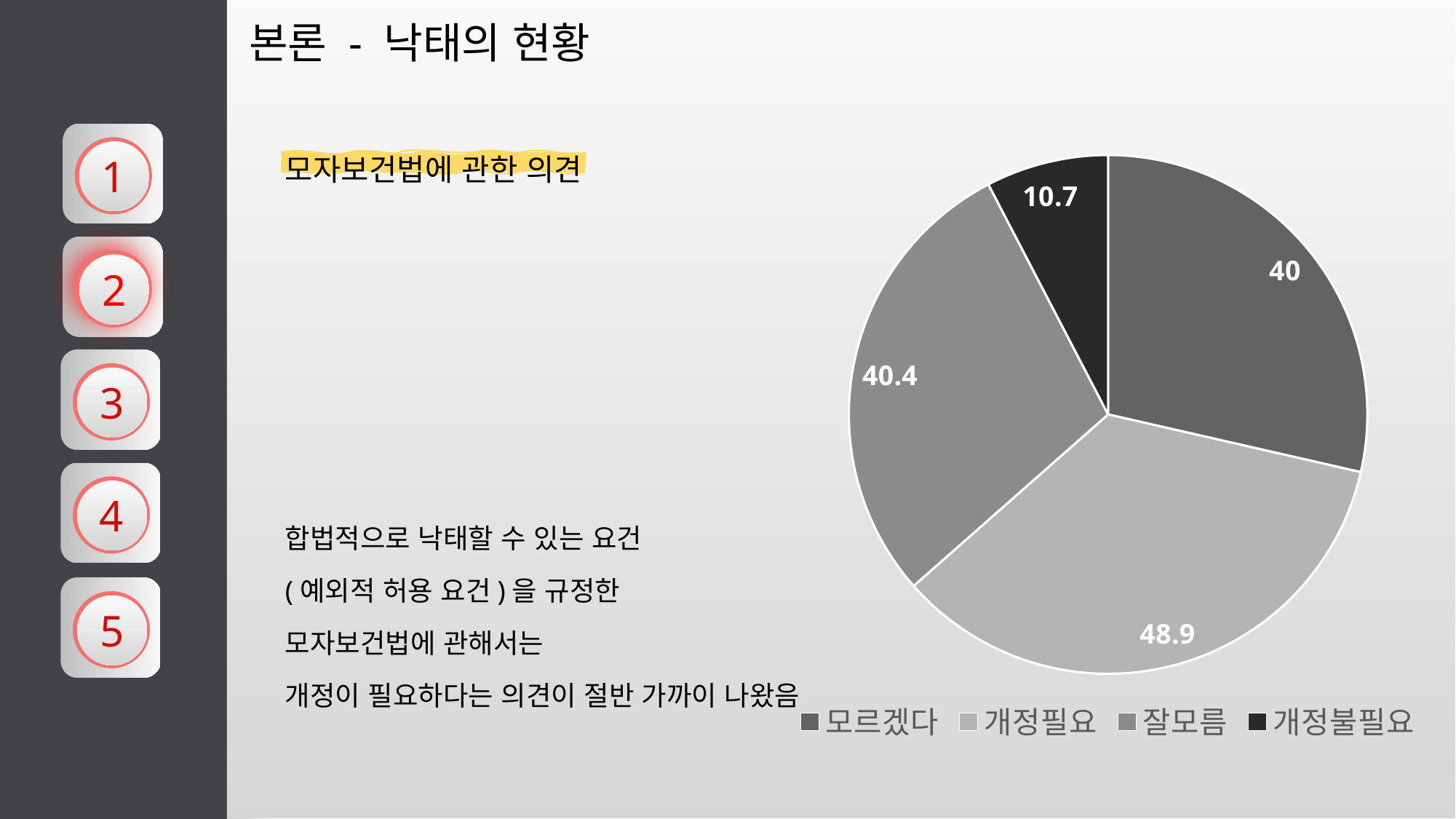
Which category has the largest slice in the pie chart? 개정필요 What is the difference between the values for 개정필요 and 개정불필요? 38.2 What is the value for 개정필요 in the pie chart? 48.9 What is the value for 모르겠다 in the pie chart? 40 What is the value for 잘모름 in the pie chart? 40.4 What is the value for 개정불필요 in the pie chart? 10.7 Which category is shown in black in the pie chart? 개정불필요 Which is larger, the value for 개정필요 or the value for 모르겠다? 개정필요 Which category has the smallest slice in the pie chart? 개정불필요 How many slices does the pie chart have? 4 What type of chart is shown on the slide? pie chart What is the difference between the values for 잘모름 and 모르겠다? 0.4